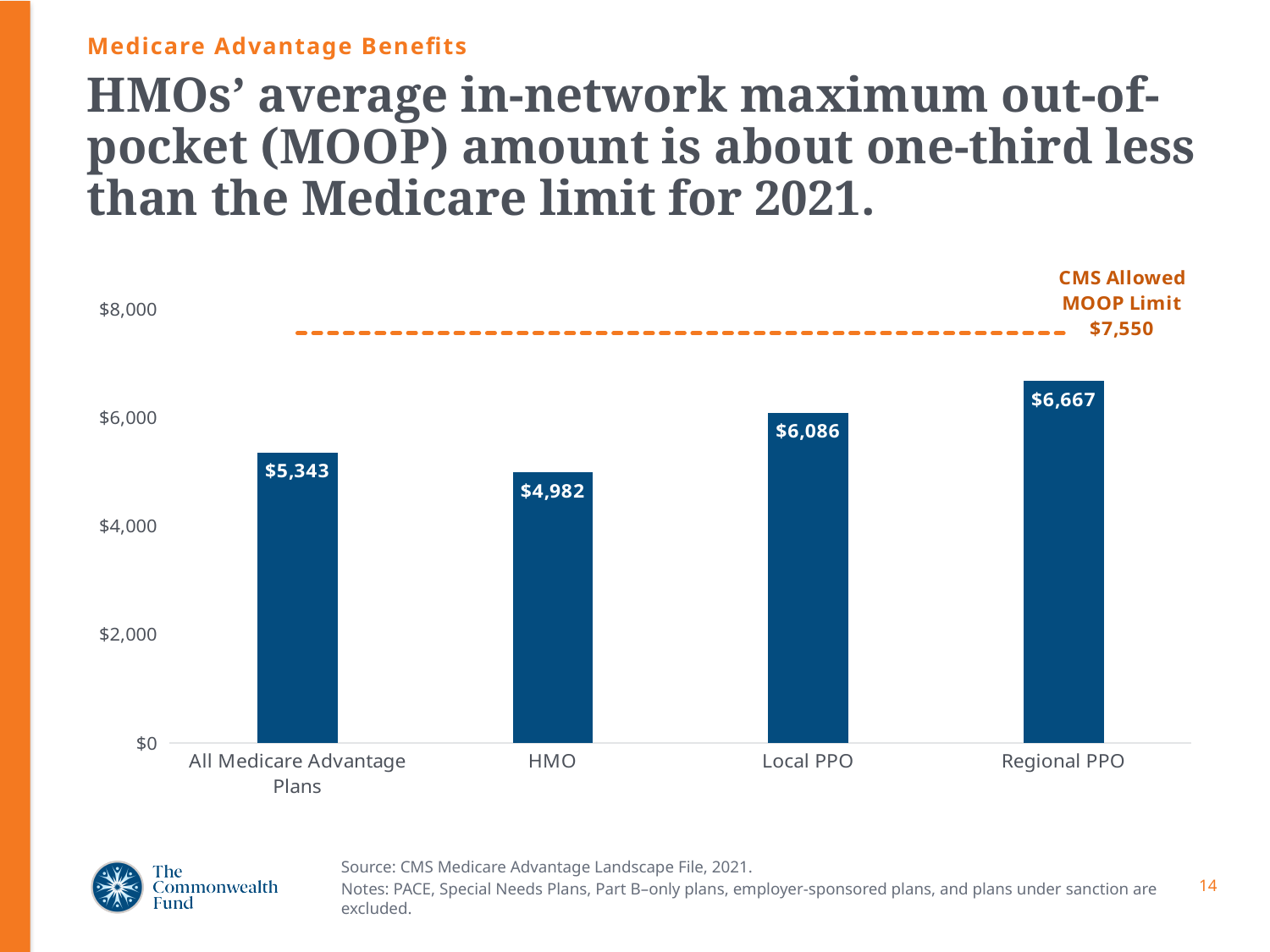
How many plan categories are shown as bars in the chart? 4 What is the label of the dashed horizontal line on the chart? CMS Allowed MOOP Limit What is the average in-network MOOP amount for HMO plans? $4,982 What is the value shown for All Medicare Advantage Plans? $5,343 Which plan type has the lowest average MOOP amount? HMO How much lower is the HMO MOOP amount than the CMS Allowed MOOP Limit? $2,568 What is the average in-network MOOP amount for Regional PPO plans? $6,667 What is the CMS Allowed MOOP Limit shown by the dashed line? $7,550 Which plan type has the highest average MOOP amount? Regional PPO What type of chart is shown on the slide? Bar chart What is the difference between the Regional PPO and HMO MOOP amounts? $1,685 Which is larger, the MOOP amount for Local PPO or for All Medicare Advantage Plans? Local PPO